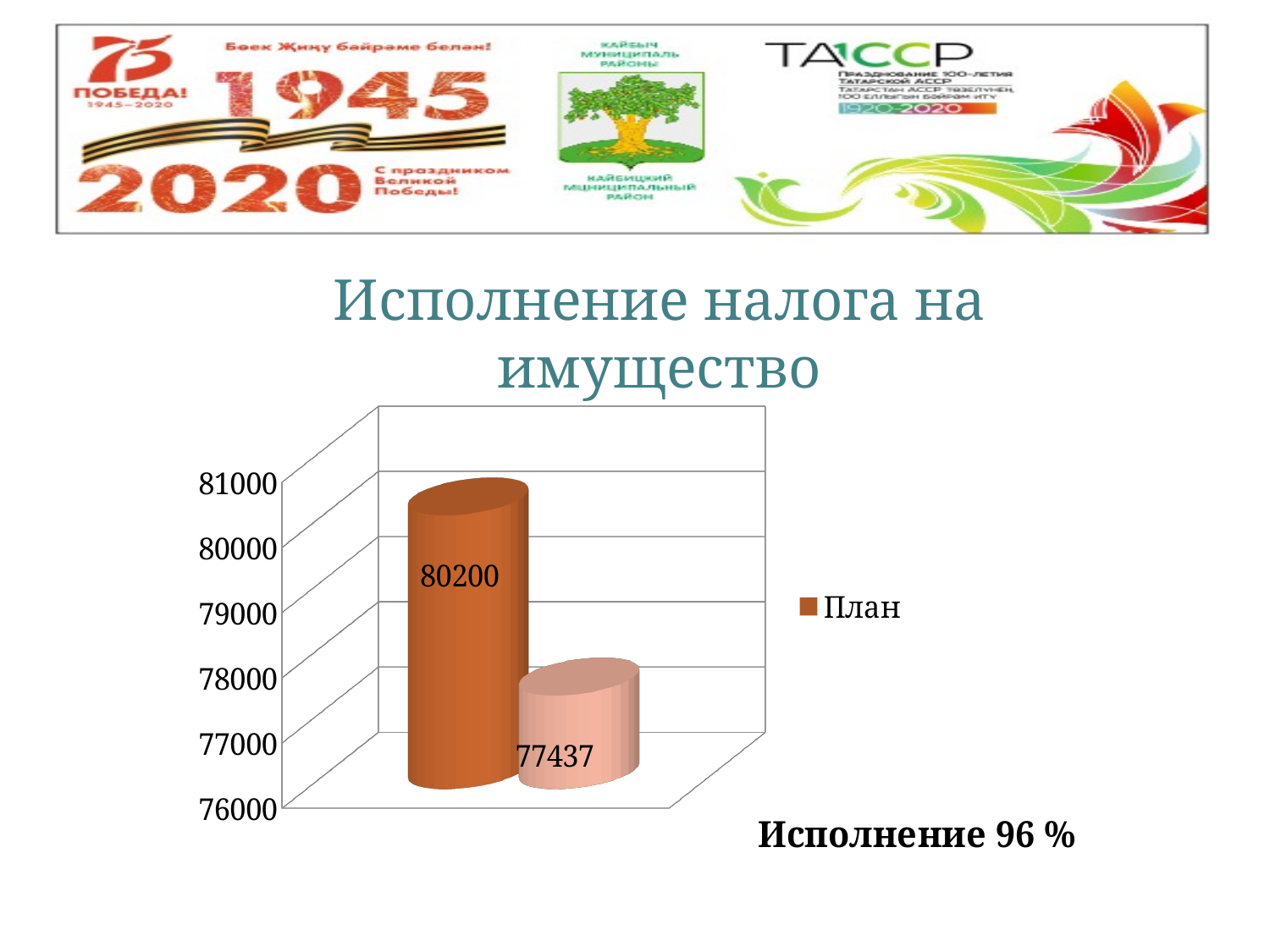
What value is printed on the lighter pink bar in the chart? 77437 What is the difference between the two bar values shown in the chart (80200 and 77437)? 2763 What is the value of the План bar in the chart? 80200 Which bar is taller, the dark orange План bar or the lighter pink bar? the dark orange План bar How many bars are plotted in the chart? 2 Is the value of the План bar greater or less than 80000? greater How many series does the chart legend list? 1 What kind of chart is shown on the slide? bar chart Is the value of the lighter pink bar greater or less than 78000? less What is the only entry shown in the chart legend? План What is the lowest value printed on the chart's vertical axis? 76000